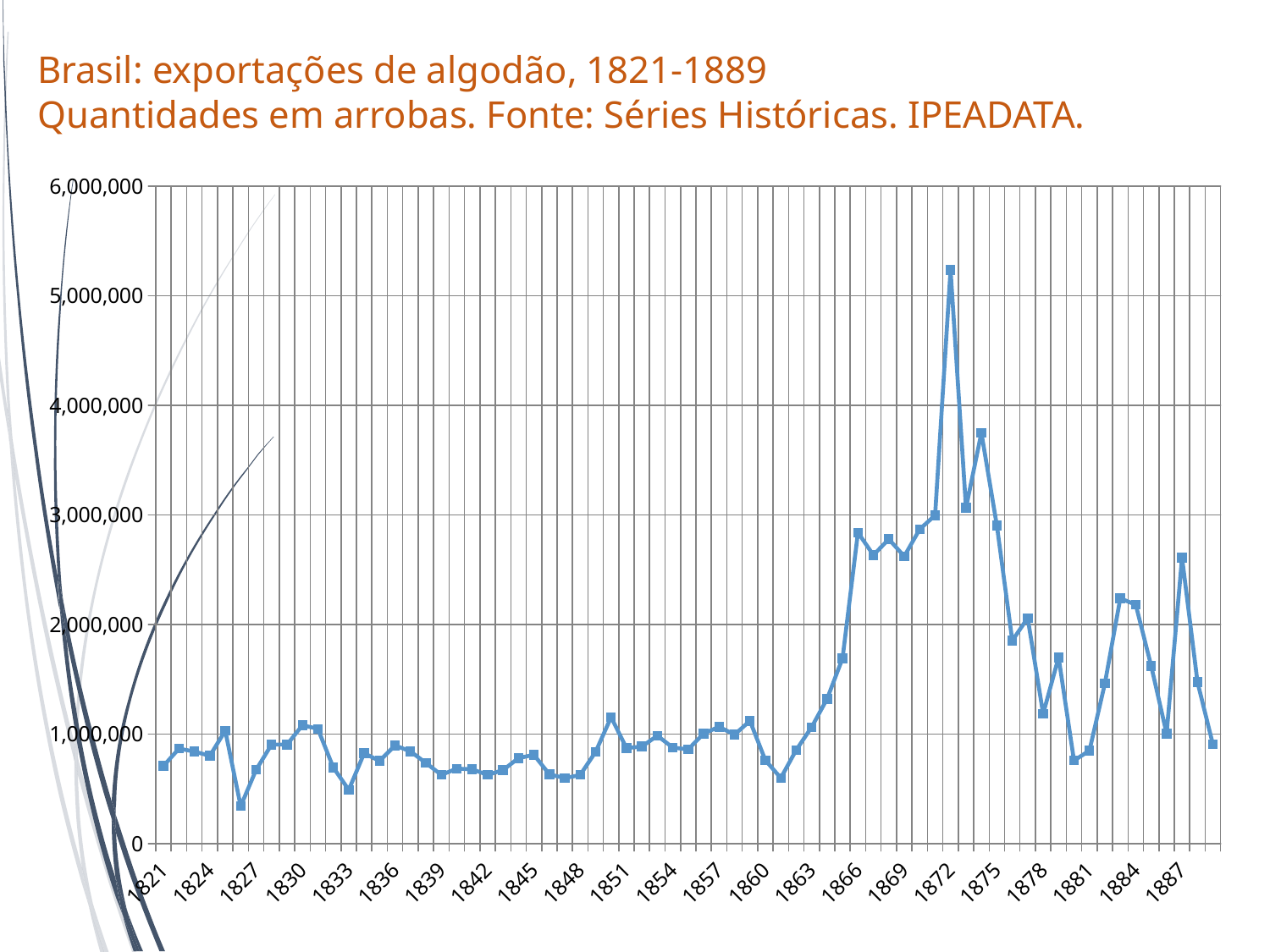
Is the value for 1826 greater or less than 1,000,000? less Is the value for 1872 greater or less than 5,000,000? greater In which year do Brazil's cotton exports reach their lowest value? 1826 What kind of chart is shown on the slide? line chart Is the value for 1880 greater or less than 1,000,000? less Do the values rise or fall between 1863 and 1866? rise Which year has the larger value, 1866 or 1887? 1866 Which year has the larger value, 1872 or 1874? 1872 In which year do Brazil's cotton exports reach their highest value? 1872 What is the highest value shown on the vertical axis? 6,000,000